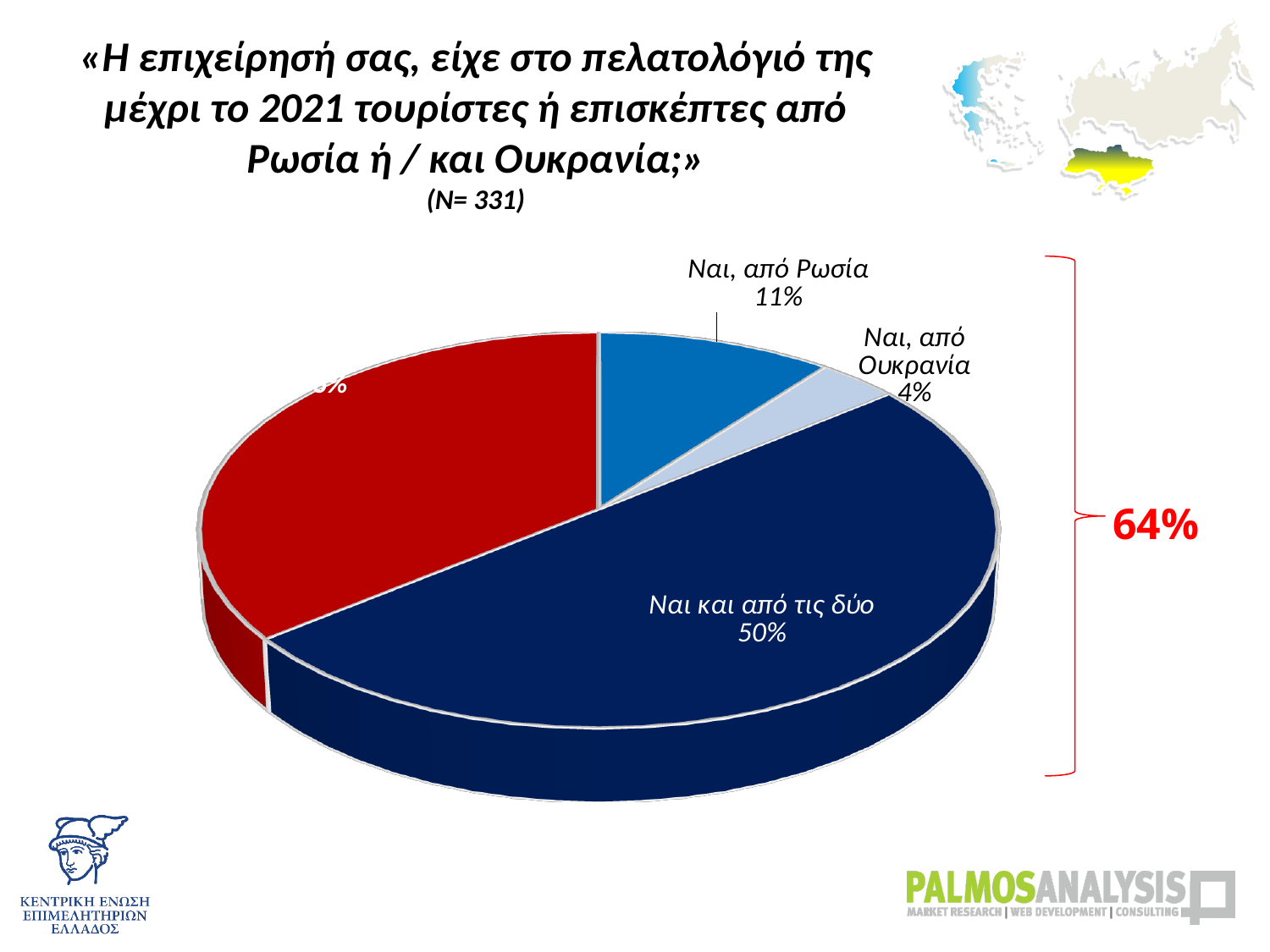
What combined percentage does the red bracket on the right of the chart indicate? 64% How many percentage points larger is "Ναι, από Ρωσία" than "Ναι, από Ουκρανία"? 7 percentage points What percentage of respondents answered "Ναι και από τις δύο"? 50% Which slice of the pie chart is the largest? Ναι και από τις δύο What is the difference in percentage points between "Ναι και από τις δύο" and "Ναι, από Ρωσία"? 39 percentage points What percentage of respondents answered "Ναι, από Ρωσία"? 11% How many slices does the pie chart have? 4 What kind of chart is shown on the slide? Pie chart What is the sample size (N) stated under the chart title? 331 Which is larger, the share for "Ναι, από Ρωσία" or the share for "Ναι, από Ουκρανία"? Ναι, από Ρωσία What percentage of respondents answered "Ναι, από Ουκρανία"? 4% Which slice of the pie chart is the smallest? Ναι, από Ουκρανία